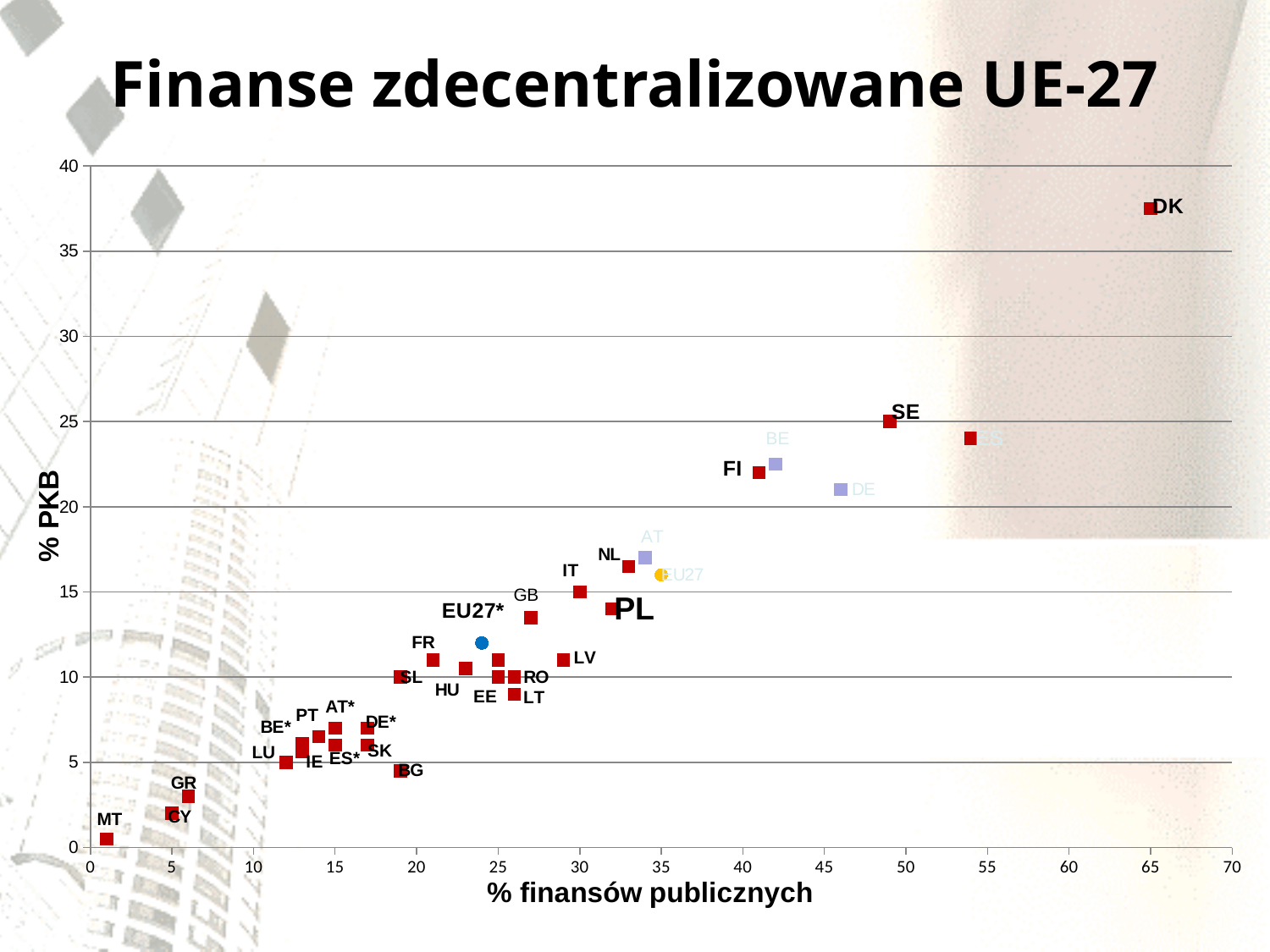
Is the % finansów publicznych value for DK greater or less than 60? greater Is the % PKB value for PL greater or less than 15? less Which country has the highest value on the % finansów publicznych axis? DK What is the title of the chart? Finanse zdecentralizowane UE-27 Which has a higher % PKB value, DK or SE? DK Is the % PKB value for MT greater or less than 5? less Which country has the lowest % PKB value? MT What kind of chart is shown on the slide? scatter chart Which country has the highest % PKB value? DK What is the label of the horizontal axis? % finansów publicznych Which has a higher % PKB value, FI or FR? FI